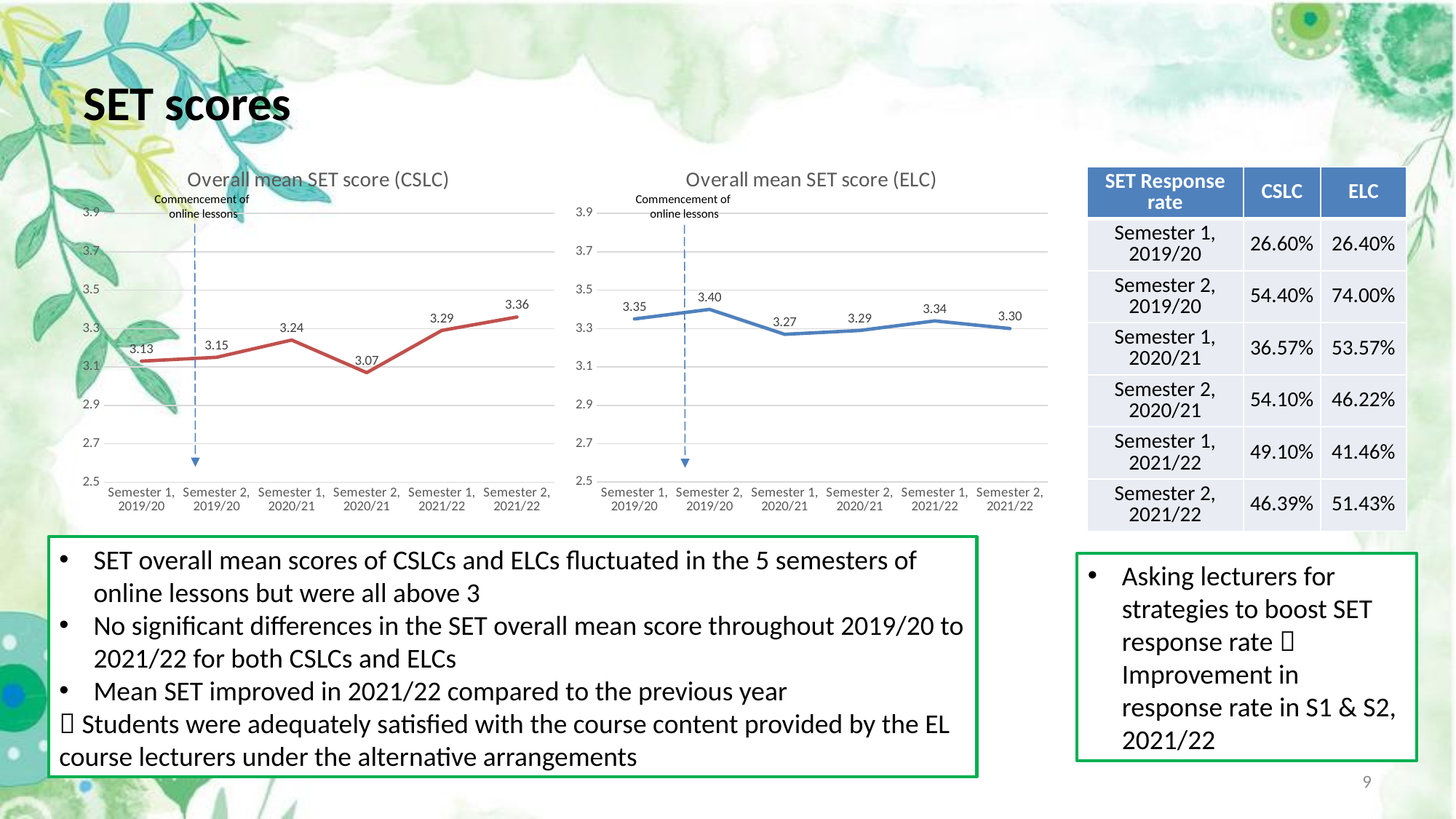
In the 'Overall mean SET score (CSLC)' chart, which semester has the lowest score? Semester 2, 2020/21 In the 'Overall mean SET score (CSLC)' chart, which is larger: the score for Semester 1, 2020/21 or Semester 2, 2020/21? Semester 1, 2020/21 In the 'Overall mean SET score (CSLC)' chart, what is the difference between the scores for Semester 2, 2021/22 and Semester 2, 2020/21? 0.29 In the 'Overall mean SET score (ELC)' chart, which semester has the lowest score? Semester 1, 2020/21 In the 'Overall mean SET score (ELC)' chart, what is the difference between the scores for Semester 2, 2019/20 and Semester 1, 2020/21? 0.13 How many semesters are plotted in the 'Overall mean SET score (ELC)' chart? 6 In the 'Overall mean SET score (ELC)' chart, what is the value for Semester 2, 2019/20? 3.40 In the 'Overall mean SET score (CSLC)' chart, what event does the dashed vertical arrow mark? Commencement of online lessons What type of chart is the 'Overall mean SET score (CSLC)' chart? Line chart In the 'Overall mean SET score (ELC)' chart, which semester has the highest score? Semester 2, 2019/20 In the 'Overall mean SET score (CSLC)' chart, what is the value for Semester 2, 2020/21? 3.07 In the 'Overall mean SET score (CSLC)' chart, which semester has the highest score? Semester 2, 2021/22